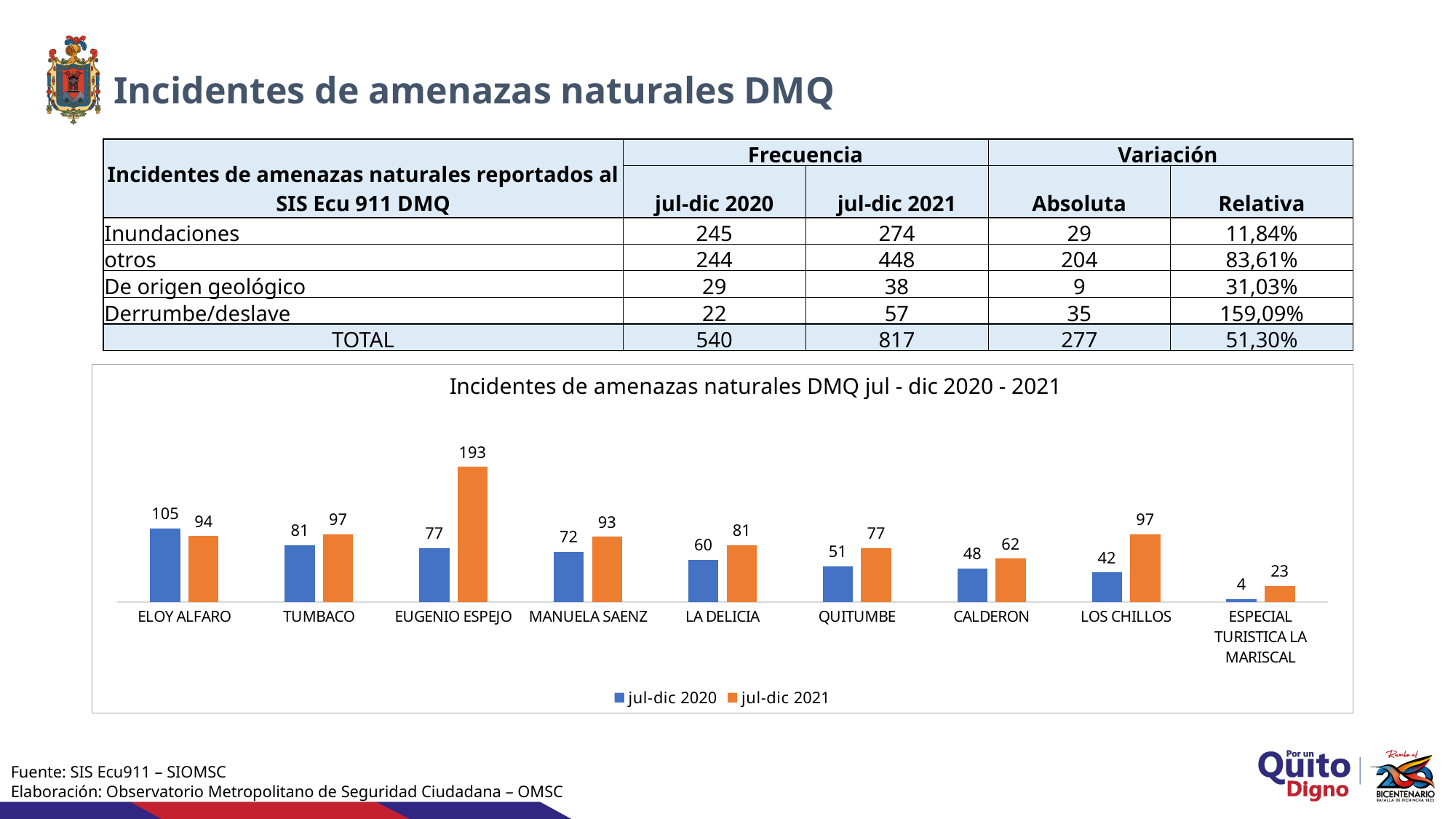
What is the difference between the jul-dic 2021 and jul-dic 2020 values for EUGENIO ESPEJO? 116 How many categories are shown on the x axis of the chart? 9 Which is larger for ELOY ALFARO, the jul-dic 2020 value or the jul-dic 2021 value? jul-dic 2020 What kind of chart is shown on the slide? Bar chart Which category has the lowest jul-dic 2020 value? ESPECIAL TURISTICA LA MARISCAL Which is larger for LOS CHILLOS, the jul-dic 2020 value or the jul-dic 2021 value? jul-dic 2021 How many series does the chart legend list? 2 What is the title of the chart? Incidentes de amenazas naturales DMQ jul - dic 2020 - 2021 Which category has the highest jul-dic 2021 value? EUGENIO ESPEJO What is the jul-dic 2020 value for ELOY ALFARO? 105 What is the jul-dic 2021 value for EUGENIO ESPEJO? 193 What is the jul-dic 2021 value for ESPECIAL TURISTICA LA MARISCAL? 23